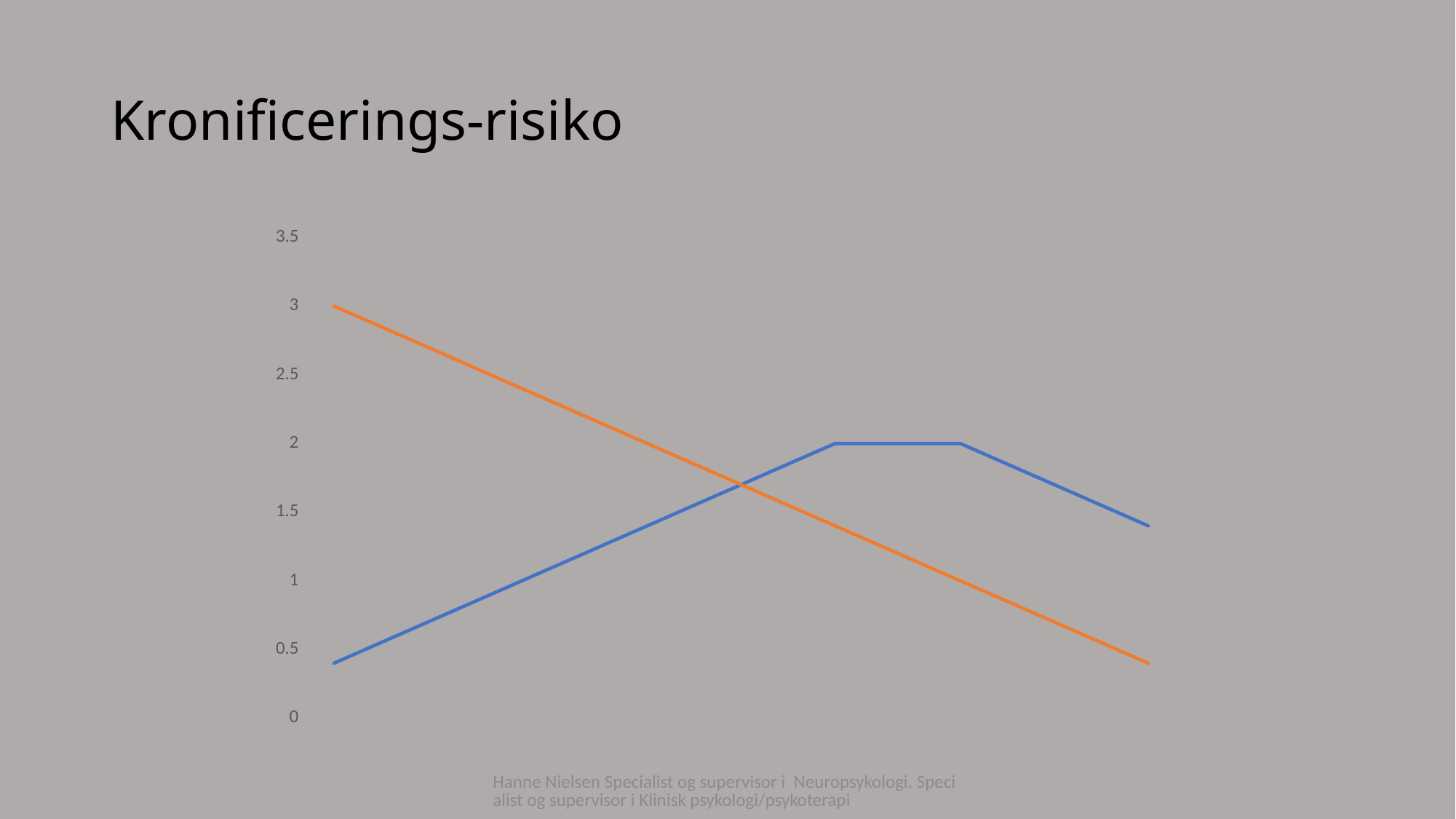
At the right end of the chart, which line is higher, the blue or the orange? blue What is the title of the chart on the slide? Kronificerings-risiko At the left end of the chart, which line is higher, the blue or the orange? orange Is the final value of the blue line on the right greater or less than 1? greater What colours are the two lines on the chart? blue and orange Does the orange line rise or fall from left to right? fall What kind of chart is shown on the slide? line chart At what value does the orange line start on the left? 3 What is the highest value the blue line reaches? 2 How many lines are plotted on the chart? 2 Is the starting value of the blue line greater or less than 1? less Is the final value of the orange line on the right greater or less than 1? less